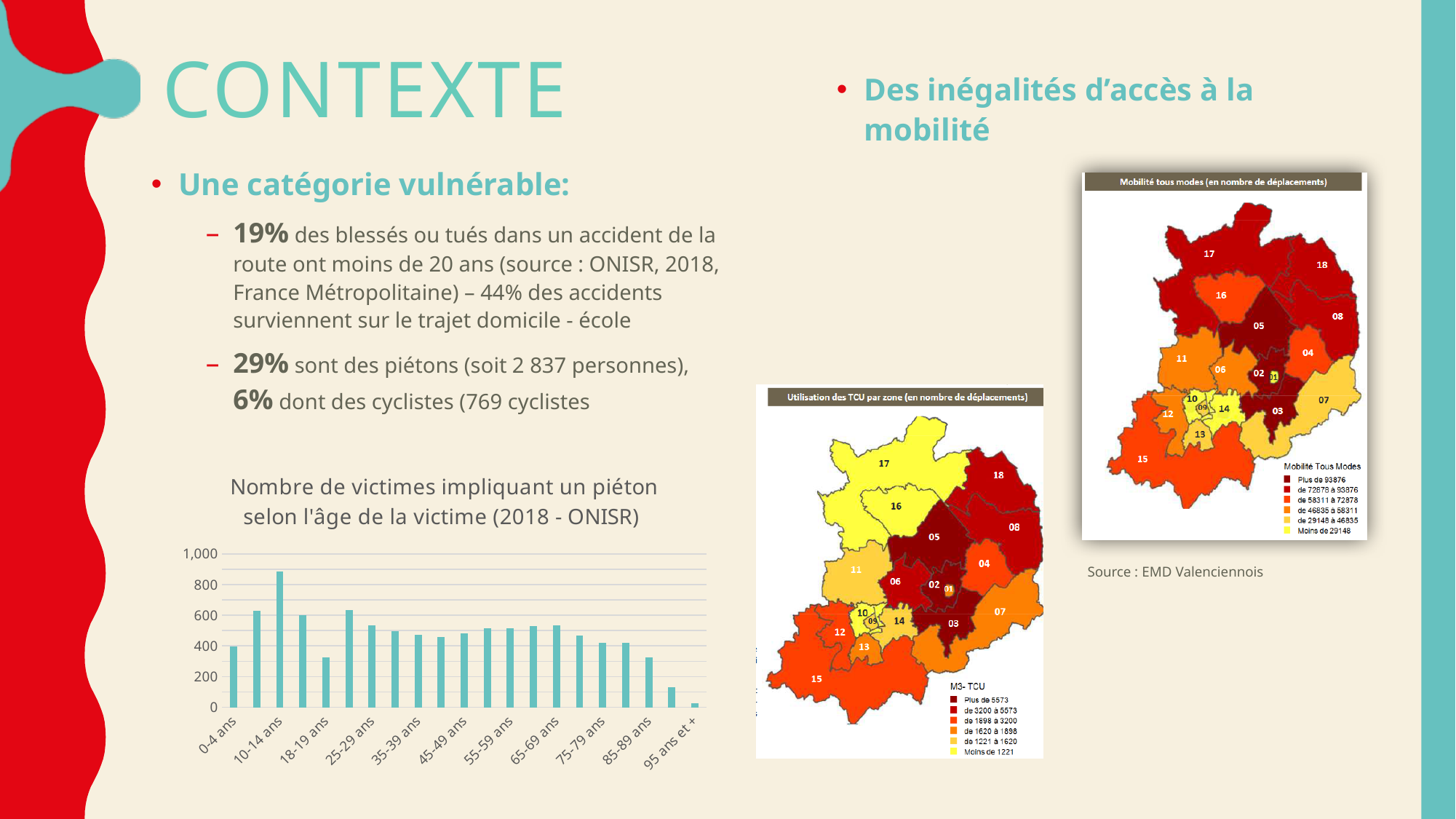
Is the value for 85-89 ans greater or less than 400? less Is the value for 10-14 ans greater or less than 800? greater Which age category has the lowest number of victims in the bar chart? 95 ans et + What is the highest value shown on the vertical axis of the bar chart? 1,000 Is the value for 18-19 ans greater or less than 400? less Which is larger, the value for 10-14 ans or the value for 0-4 ans? 10-14 ans What kind of chart is shown on the slide? bar chart Which age category has the highest number of victims in the bar chart? 10-14 ans Which is larger, the value for 65-69 ans or the value for 85-89 ans? 65-69 ans What is the title of the bar chart? Nombre de victimes impliquant un piéton selon l'âge de la victime (2018 - ONISR)